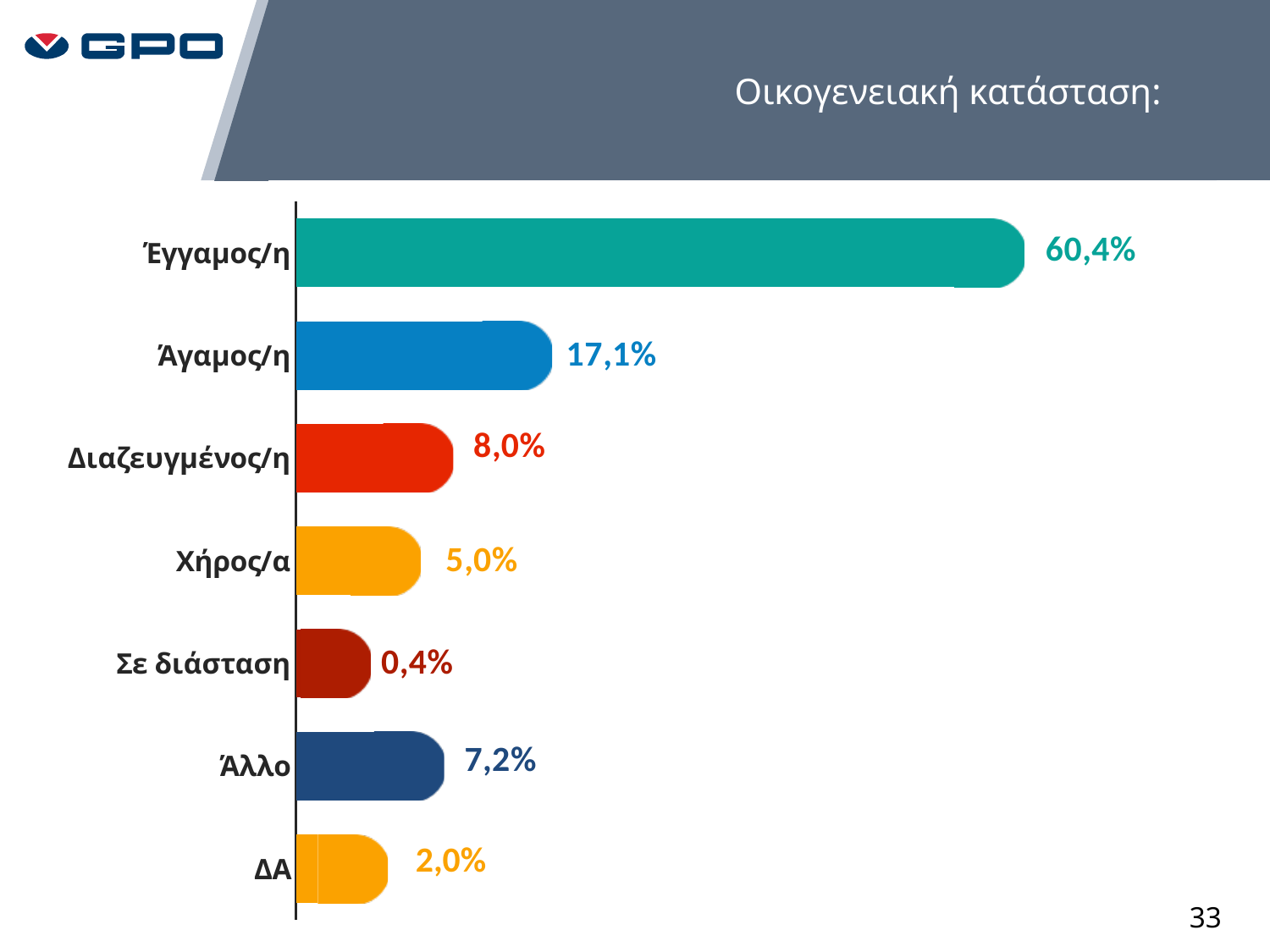
What is the difference between the values for Έγγαμος/η and Άγαμος/η? 43,3% Which category has the highest value? Έγγαμος/η What is the title of the slide? Οικογενειακή κατάσταση: What is the value for Σε διάσταση? 0,4% What is the value for ΔΑ? 2,0% What is the value for Έγγαμος/η? 60,4% What is the value for Διαζευγμένος/η? 8,0% What kind of chart is shown on the slide? Bar chart Which category has the lowest value? Σε διάσταση How many categories are shown in the chart? 7 What is the value for Άγαμος/η? 17,1% Which is larger, the value for Διαζευγμένος/η or the value for Άλλο? Διαζευγμένος/η